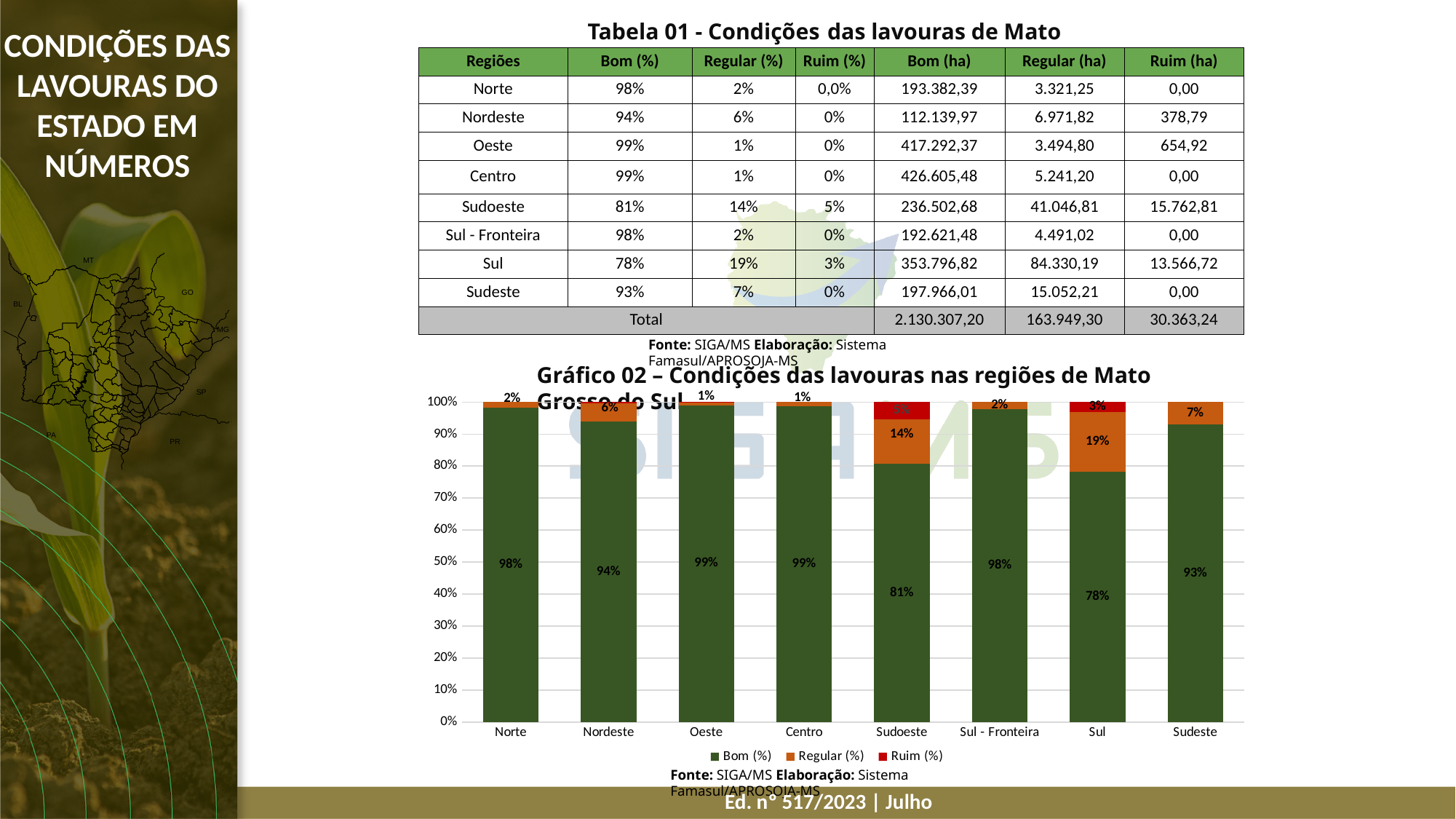
In Gráfico 02, what is the Bom (%) value for Sudoeste? 81% How many series does the legend of Gráfico 02 list? 3 How many regions are shown on the x axis of Gráfico 02? 8 In Gráfico 02, what is the Ruim (%) value for Sudoeste? 5% In Gráfico 02, which region has the larger Bom (%) value, Sudoeste or Sul? Sudoeste In Gráfico 02, what is the difference between the Regular (%) values for Sul and Sudoeste? 5% In Gráfico 02, what is the Regular (%) value for Sul? 19% What kind of chart is Gráfico 02? Stacked bar chart In Gráfico 02, which colour represents the Bom (%) series? Green In Gráfico 02, which region has the lowest Bom (%) value? Sul In Gráfico 02, which region has the highest Regular (%) value? Sul In Gráfico 02, is the Bom (%) value for Sul greater or less than 80%? less